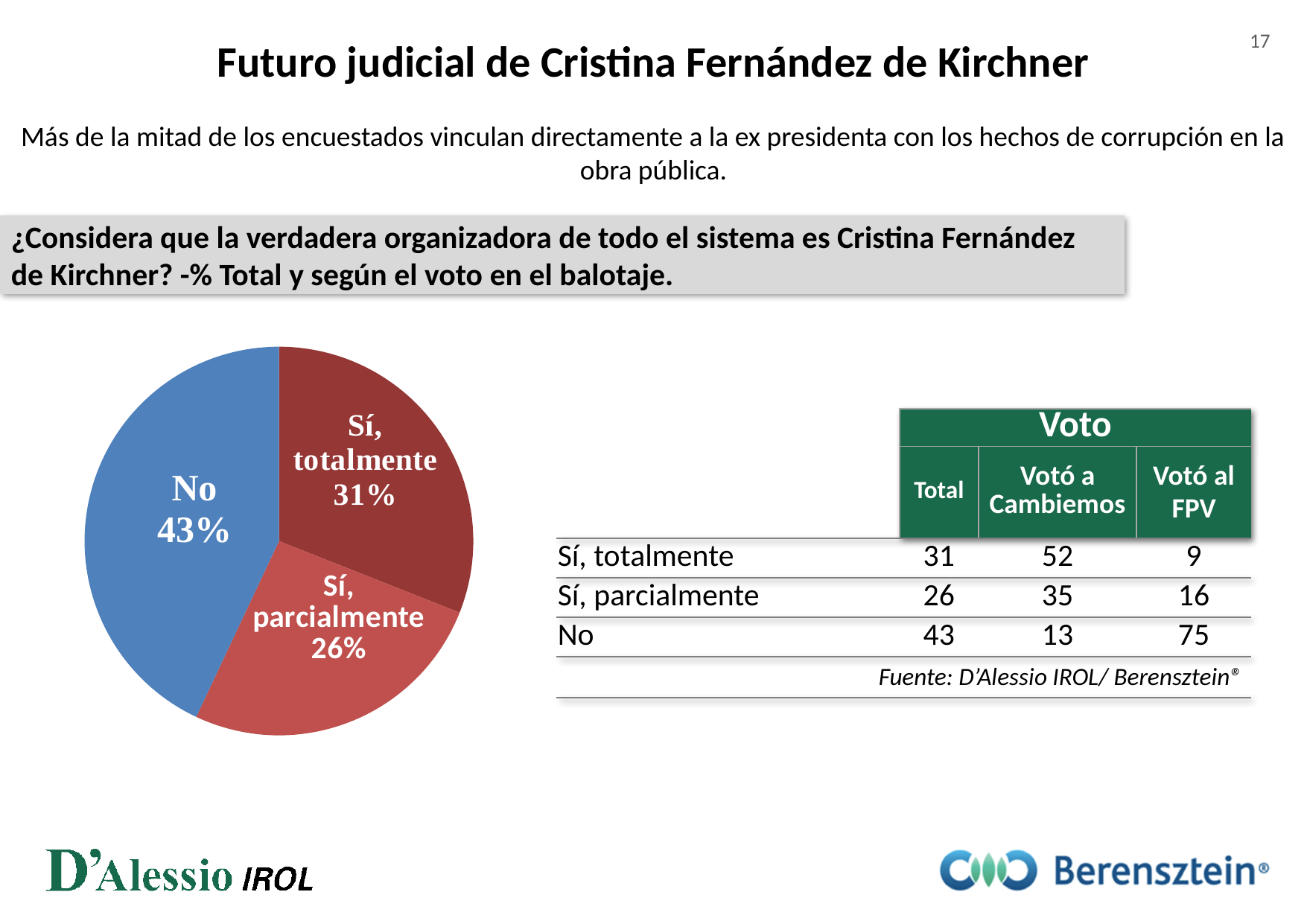
Which slice of the pie chart is the largest? No Which is larger in the pie chart, "Sí, totalmente" or "Sí, parcialmente"? Sí, totalmente What colour is the "No" slice in the pie chart? blue What is the value for the "No" slice in the pie chart? 43% Is the value for the "No" slice greater or less than 50%? less What is the value for the "Sí, parcialmente" slice in the pie chart? 26% What is the difference in percentage points between the "No" slice and the "Sí, totalmente" slice? 12 What is the value for the "Sí, totalmente" slice in the pie chart? 31% What is the combined share of the two "Sí" slices in the pie chart? 57% What kind of chart is shown on the slide? pie chart How many slices does the pie chart have? 3 Which slice of the pie chart is the smallest? Sí, parcialmente